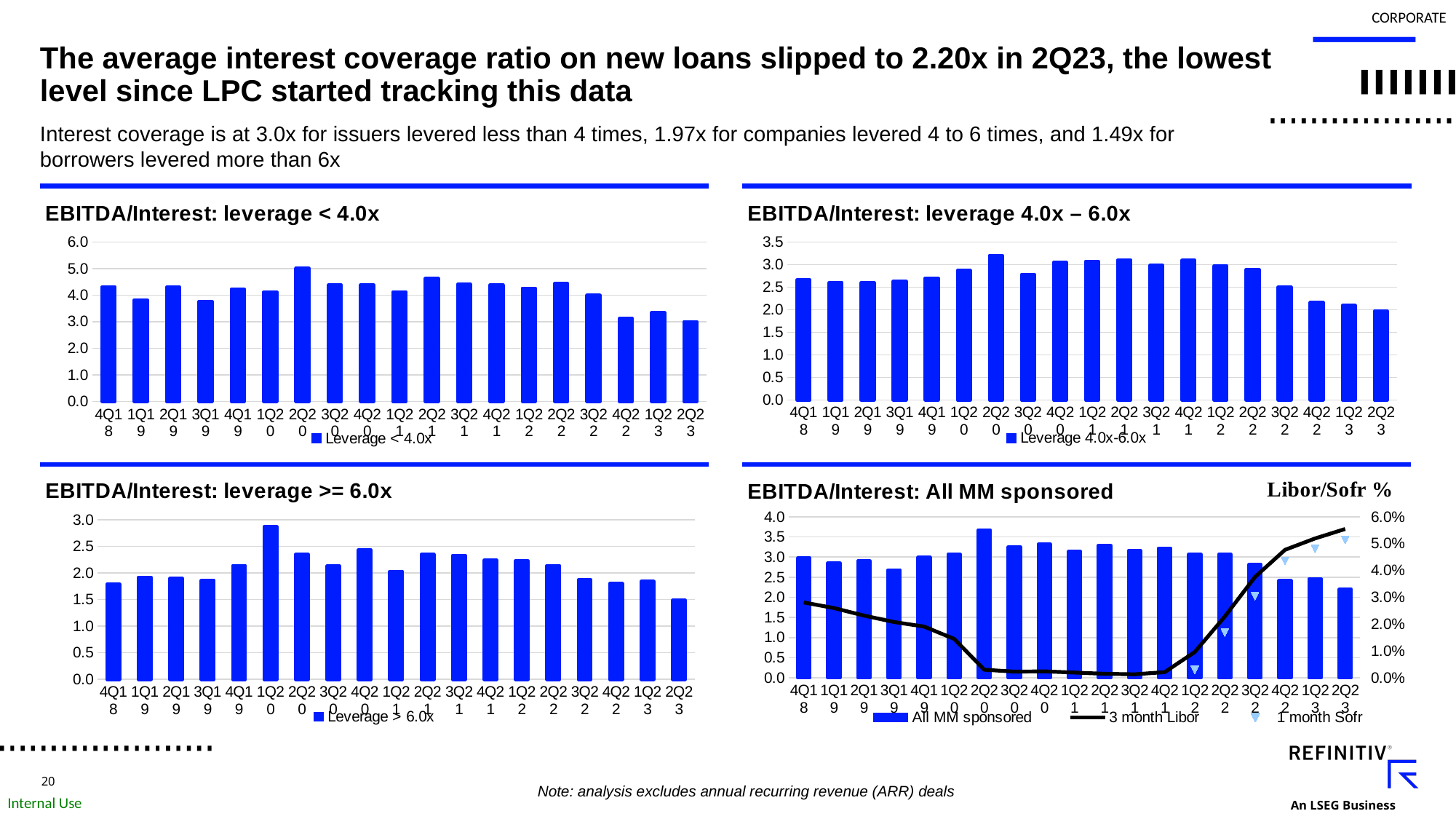
In the "EBITDA/Interest: leverage 4.0x – 6.0x" chart, is the value for 2Q23 greater or less than 2.5? less In the "EBITDA/Interest: leverage >= 6.0x" chart, is the value for 2Q23 greater or less than 2.0? less In the "EBITDA/Interest: leverage >= 6.0x" chart, which quarter has the lowest value? 2Q23 In the "EBITDA/Interest: leverage < 4.0x" chart, which quarter has the highest value? 2Q20 In the "EBITDA/Interest: leverage >= 6.0x" chart, which quarter has the highest value? 1Q20 In the "EBITDA/Interest: All MM sponsored" chart, which quarter has the highest All MM sponsored bar? 2Q20 What kind of chart is "EBITDA/Interest: leverage < 4.0x"? bar chart How many series does the legend of the "EBITDA/Interest: All MM sponsored" chart list? 3 In the "EBITDA/Interest: All MM sponsored" chart, is the 3 month Libor value for 2Q23 greater or less than 5.0%? greater In the "EBITDA/Interest: leverage 4.0x – 6.0x" chart, which quarter has the lowest value? 2Q23 How many quarters are plotted in the "EBITDA/Interest: leverage < 4.0x" chart? 19